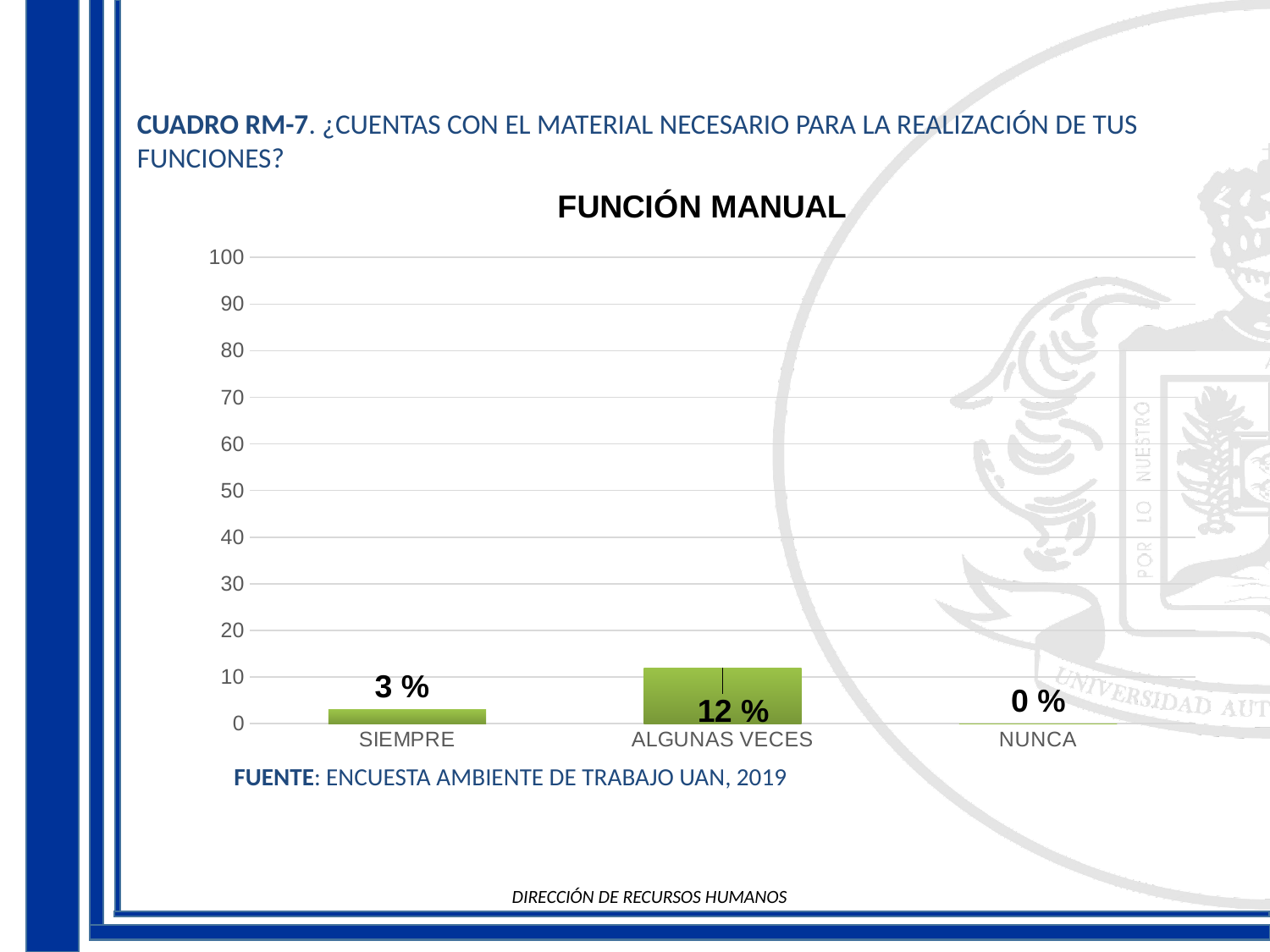
What is the value for ALGUNAS VECES? 12 % What is the maximum value shown on the y axis? 100 Which category has the highest value? ALGUNAS VECES Which is larger, the value for SIEMPRE or the value for ALGUNAS VECES? ALGUNAS VECES How many categories are shown on the x axis? 3 Which category has the lowest value? NUNCA What is the title of the chart? FUNCIÓN MANUAL What is the value for SIEMPRE? 3 % What is the difference between the values for ALGUNAS VECES and SIEMPRE? 9 % What kind of chart is shown? bar chart What is the value for NUNCA? 0 % Is the value for ALGUNAS VECES greater or less than 10? greater